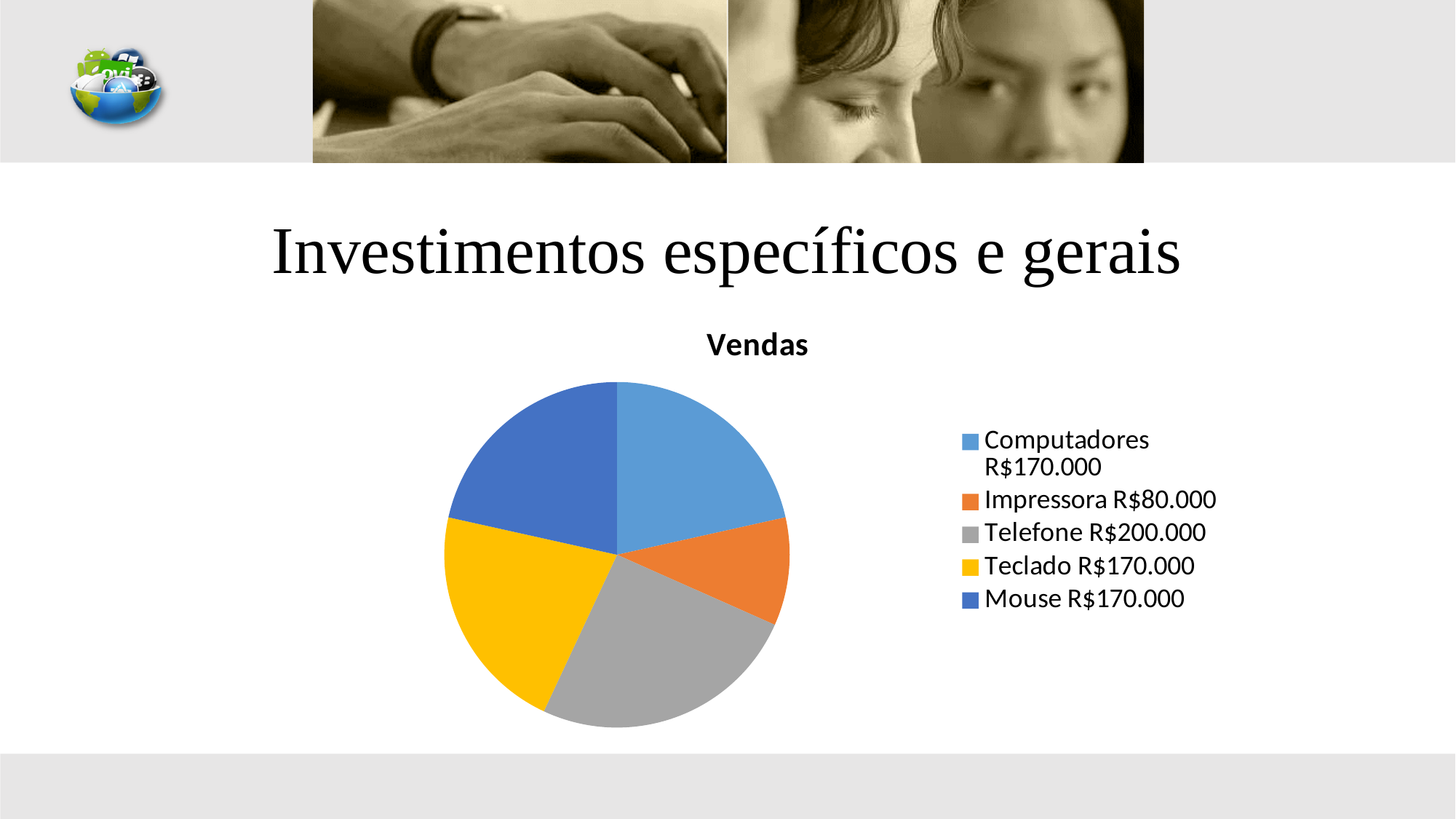
Which is larger, the value for Telefone or the value for Teclado? Telefone Which colour represents Telefone in the pie chart? grey What is the title of the chart? Vendas What is the value for Telefone? R$200.000 Which category has the smallest value? Impressora How many categories does the pie chart have? 5 Which category has the largest value? Telefone What is the difference between the values for Telefone and Impressora? R$120.000 What is the difference between the values for Computadores and Impressora? R$90.000 What is the value for Computadores? R$170.000 What is the value for Impressora? R$80.000 What kind of chart is shown on the slide? pie chart